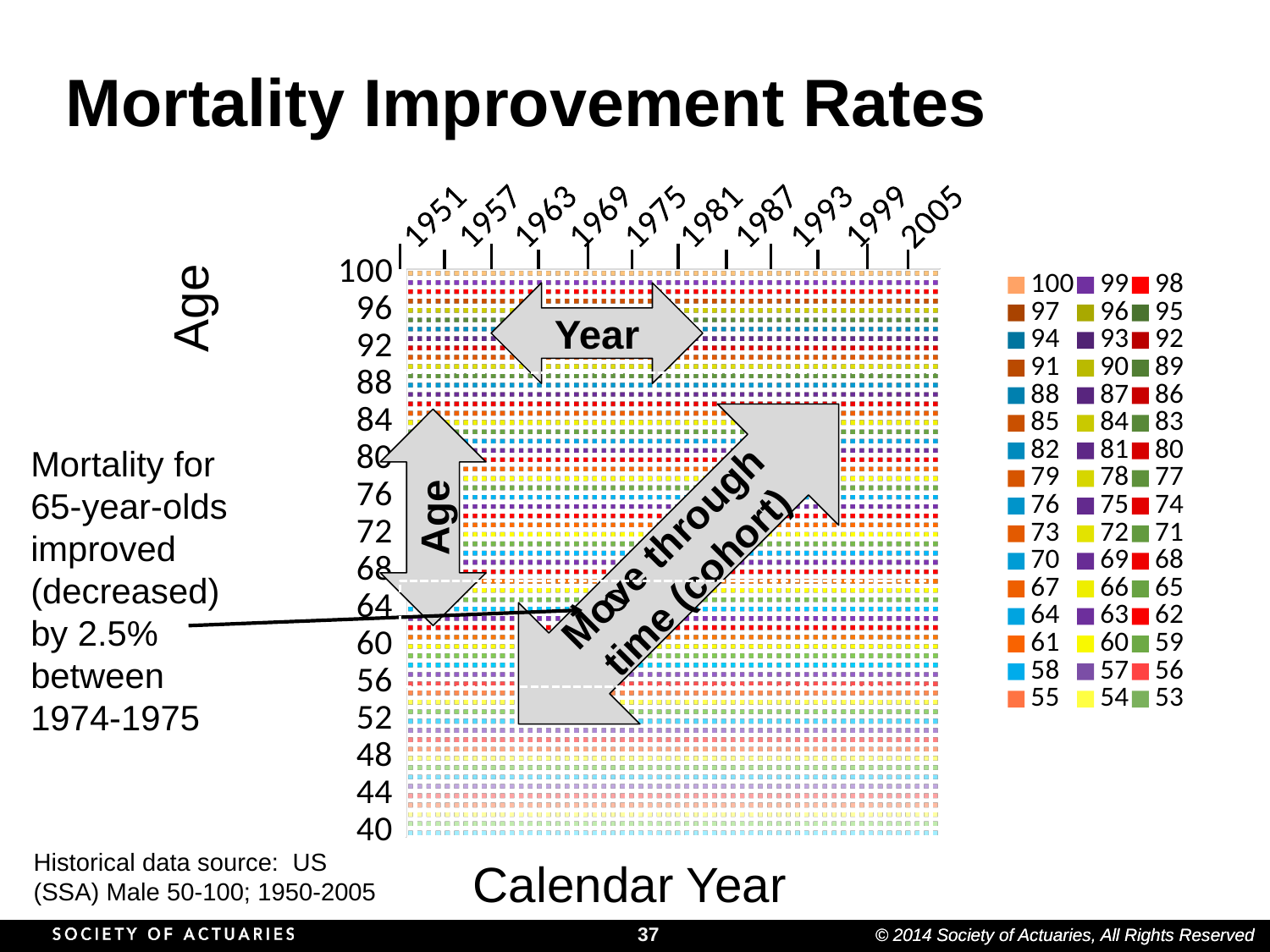
What is the title of the chart on the slide? Mortality Improvement Rates What is the highest age listed in the chart's legend? 100 What is the lowest age listed in the chart's legend? 53 What is the first year label on the chart's x axis? 1951 What is the label of the chart's horizontal axis? Calendar Year How many year labels are shown along the x axis of the chart? 10 What is the lowest age label on the chart's y axis? 40 How many series does the chart's legend list? 48 What is the highest age label on the chart's y axis? 100 What is the last year label on the chart's x axis? 2005 How many age labels are shown along the y axis of the chart? 16 According to the annotation on the slide, by what percentage did mortality for 65-year-olds improve between 1974-1975? 2.5%